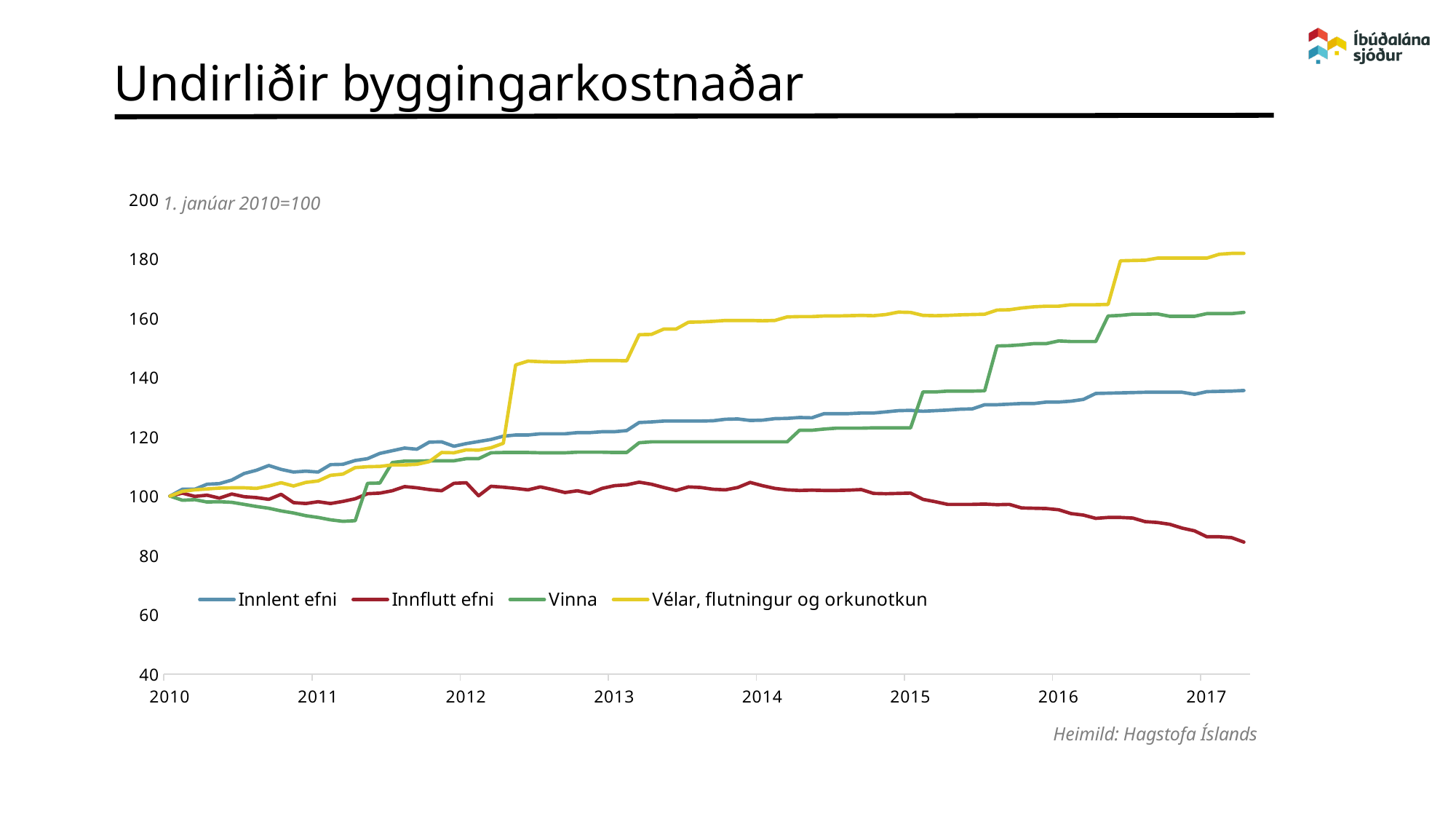
Is the value for Vinna at the end of 2017 greater or less than 160? greater Does the Innlent efni series rise or fall overall from 2010 to 2017? rise What is the title of the slide? Undirliðir byggingarkostnaðar Which is larger at the start of 2016: Vinna or Innlent efni? Vinna How many series does the legend list? 4 Which series has the highest value at the end of the chart in 2017? Vélar, flutningur og orkunotkun Does the Innflutt efni series rise or fall overall between 2015 and 2017? fall Is the value for Innflutt efni at the end of 2017 greater or less than 100? less Is the value for Vélar, flutningur og orkunotkun at the end of 2017 greater or less than 180? greater Which series has the lowest value at the end of the chart in 2017? Innflutt efni What kind of chart is shown on the slide? line chart